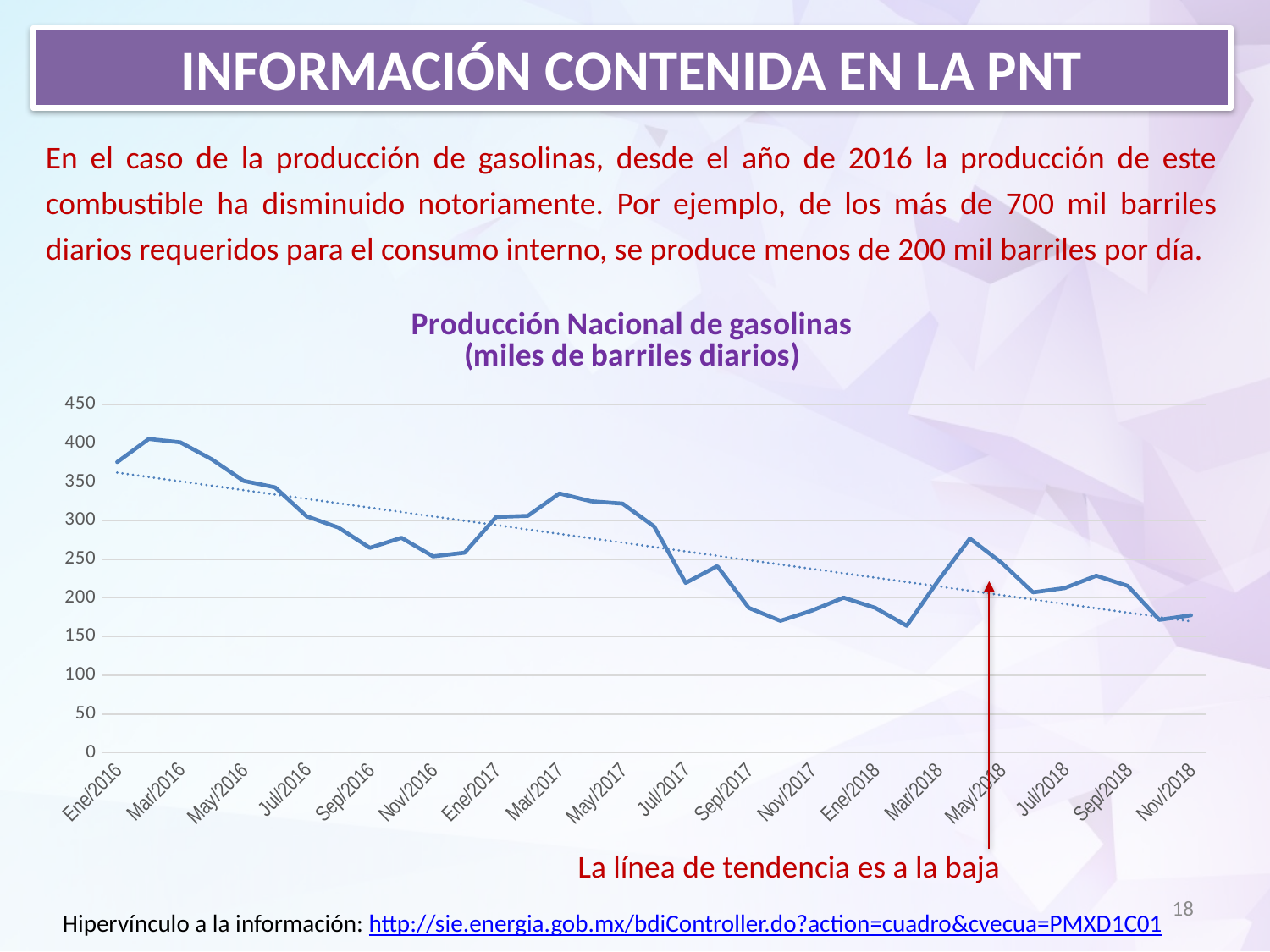
Which month shown on the x axis has the highest production value? Mar/2016 Is the value for Mar/2017 greater or less than 300? greater Do the values in the chart generally rise or fall from Ene/2016 to Nov/2018? fall What kind of chart is shown on the slide? line chart Is the value for Sep/2017 greater or less than 200? less What is the highest value shown on the y axis of the chart? 450 Is the value for Ene/2016 greater or less than 350? greater Which is larger, the value for Mar/2016 or the value for Nov/2018? Mar/2016 What is the title of the chart? Producción Nacional de gasolinas (miles de barriles diarios)